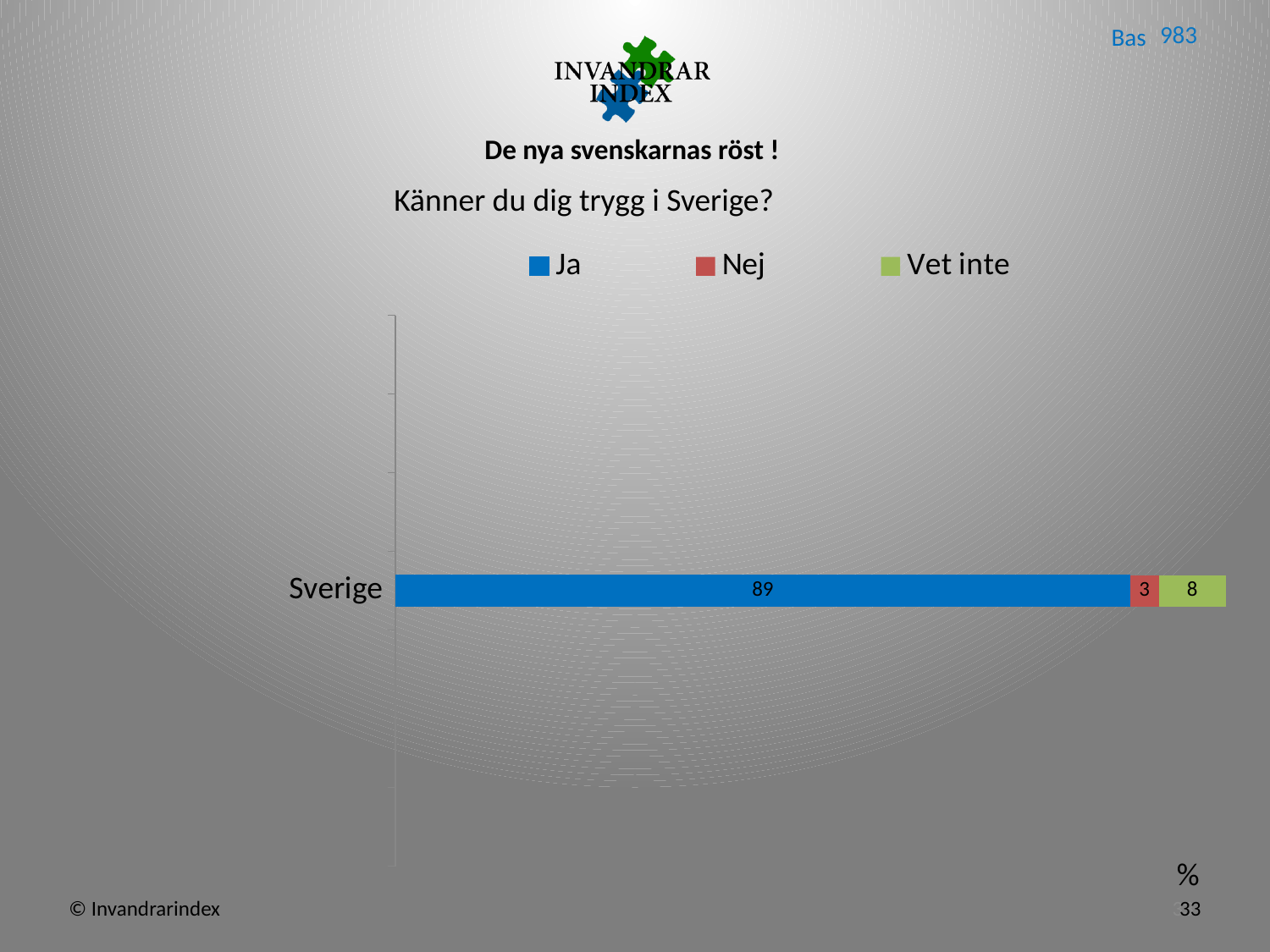
What is the difference between the Vet inte and Nej values for Sverige? 5 What is the difference between the Ja and Vet inte values for Sverige? 81 How many series does the legend list? 3 What kind of chart is shown on the slide? Stacked bar chart What is the value for Vet inte for Sverige? 8 What is the value for Ja for Sverige? 89 What is the value for Nej for Sverige? 3 Which series has the lowest value for Sverige? Nej How many categories are shown on the chart? 1 What is the total of the stacked bar for Sverige? 100 Which is larger for Sverige, Nej or Vet inte? Vet inte Which series has the highest value for Sverige? Ja